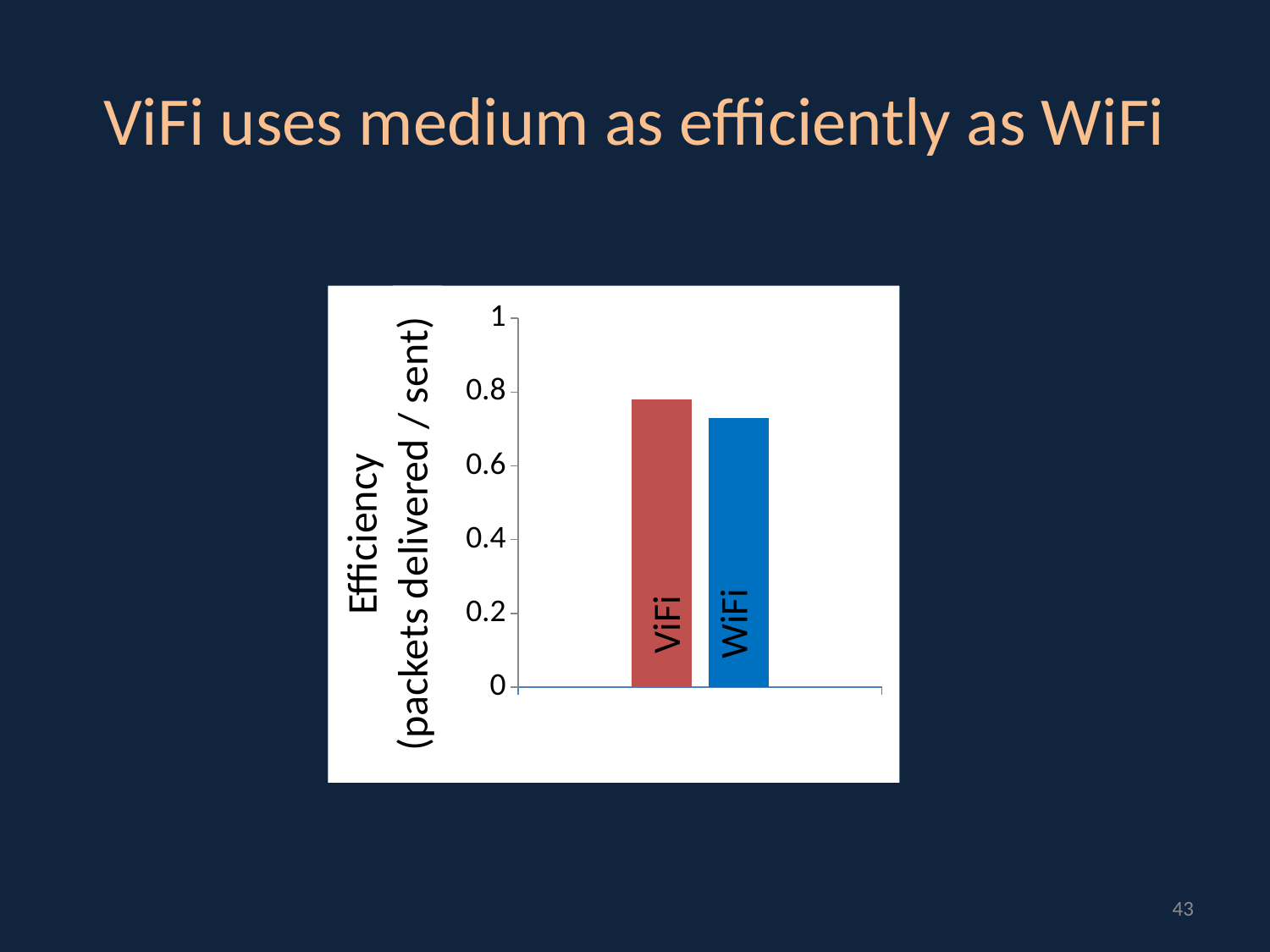
Is the value for ViFi greater or less than 0.8? less What kind of chart is shown on the slide? bar chart Is the value for WiFi greater or less than 0.8? less Which bar is taller, ViFi or WiFi? ViFi How many bars are plotted in the chart? 2 What is the maximum value shown on the vertical axis? 1 What colour is the ViFi bar? red Is the value for ViFi greater or less than 0.6? greater Which category has the lowest efficiency? WiFi What is the label of the vertical axis? Efficiency (packets delivered / sent) Which category has the highest efficiency? ViFi